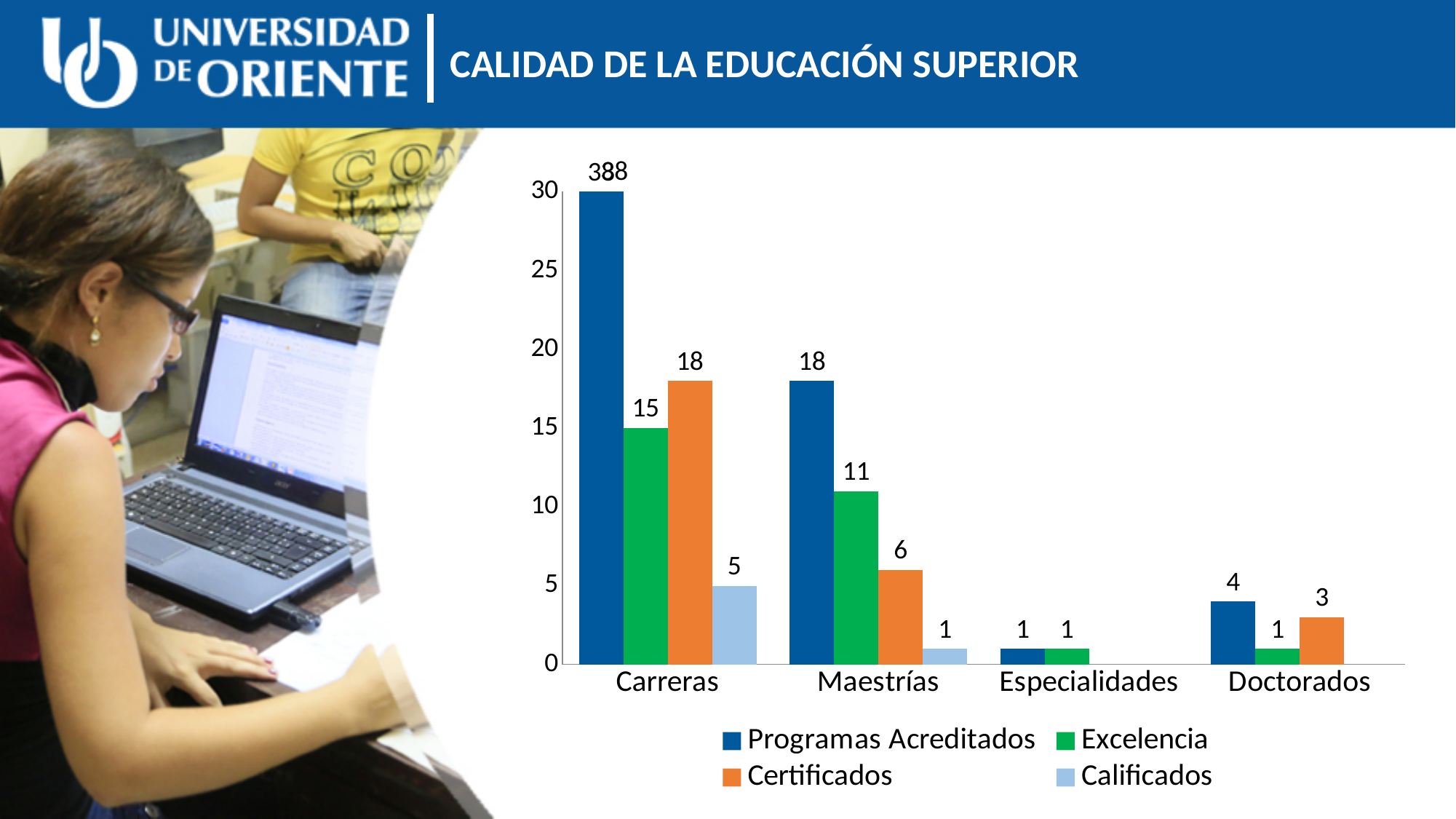
What is the value of Excelencia for Maestrías? 11 What is the value of Calificados for Maestrías? 1 What is the difference between Certificados and Excelencia for Carreras? 3 Which category has the highest value for Excelencia? Carreras What kind of chart is shown on the slide? Bar chart How many series does the legend list? 4 What is the value of Certificados for Carreras? 18 Which is larger for Maestrías: Programas Acreditados or Certificados? Programas Acreditados Which category has the lowest value for Programas Acreditados? Especialidades How many categories are shown on the x axis? 4 What is the value of Programas Acreditados for Carreras? 388 What is the value of Certificados for Doctorados? 3